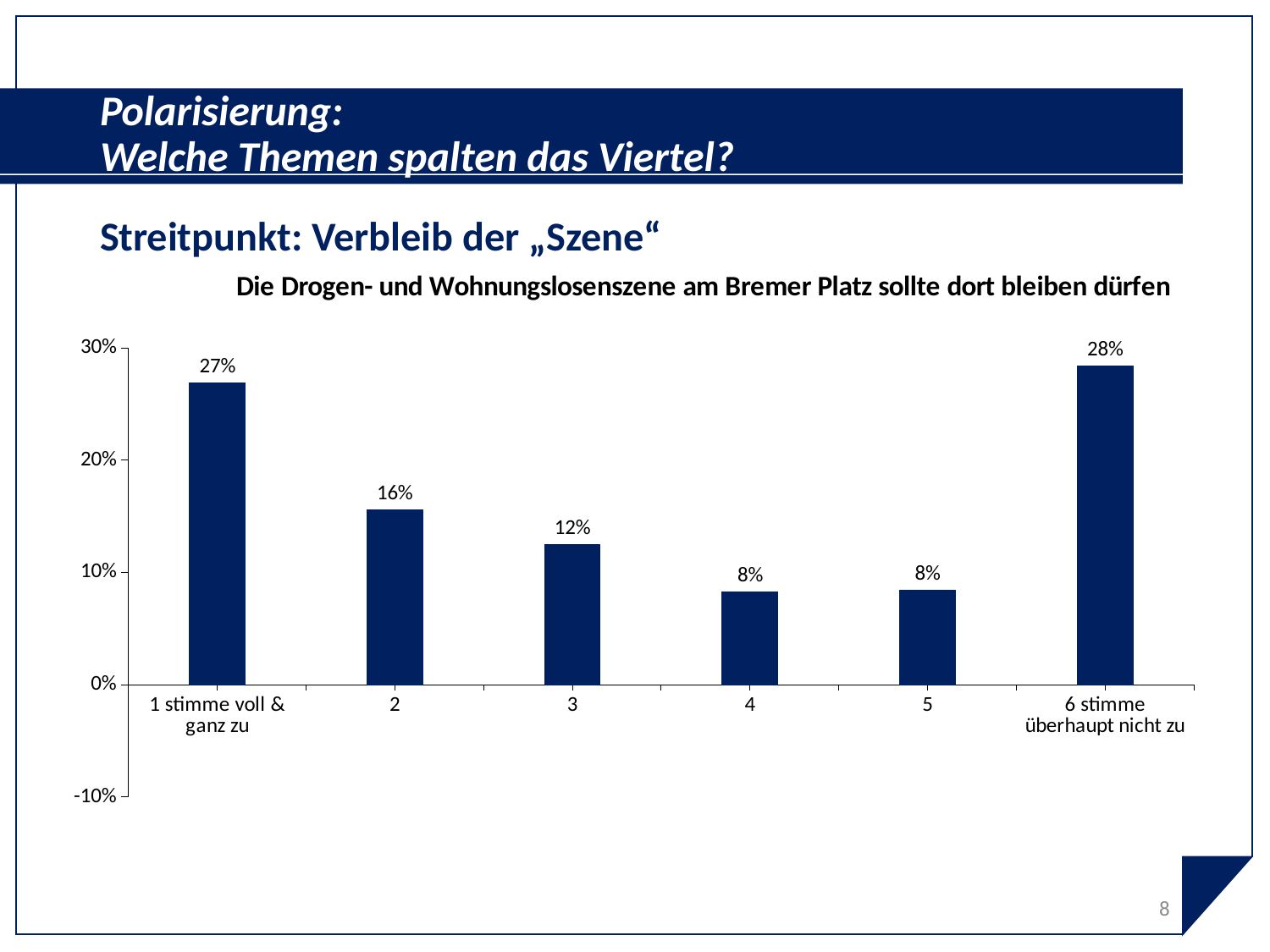
What is the value for category 2? 16% What is the value for category 5? 8% What is the value for category "1 stimme voll & ganz zu"? 27% What kind of chart is shown? bar chart Is the value for category 3 greater or less than 10%? greater What is the value for category 4? 8% What is the title of the chart? Die Drogen- und Wohnungslosenszene am Bremer Platz sollte dort bleiben dürfen What is the difference between the values for category 2 and category 3? 4% Which category has the highest value? 6 stimme überhaupt nicht zu How many categories are shown on the x axis? 6 Which is larger, the value for category 3 or the value for category 5? 3 What is the difference between the values for "6 stimme überhaupt nicht zu" and "1 stimme voll & ganz zu"? 1%